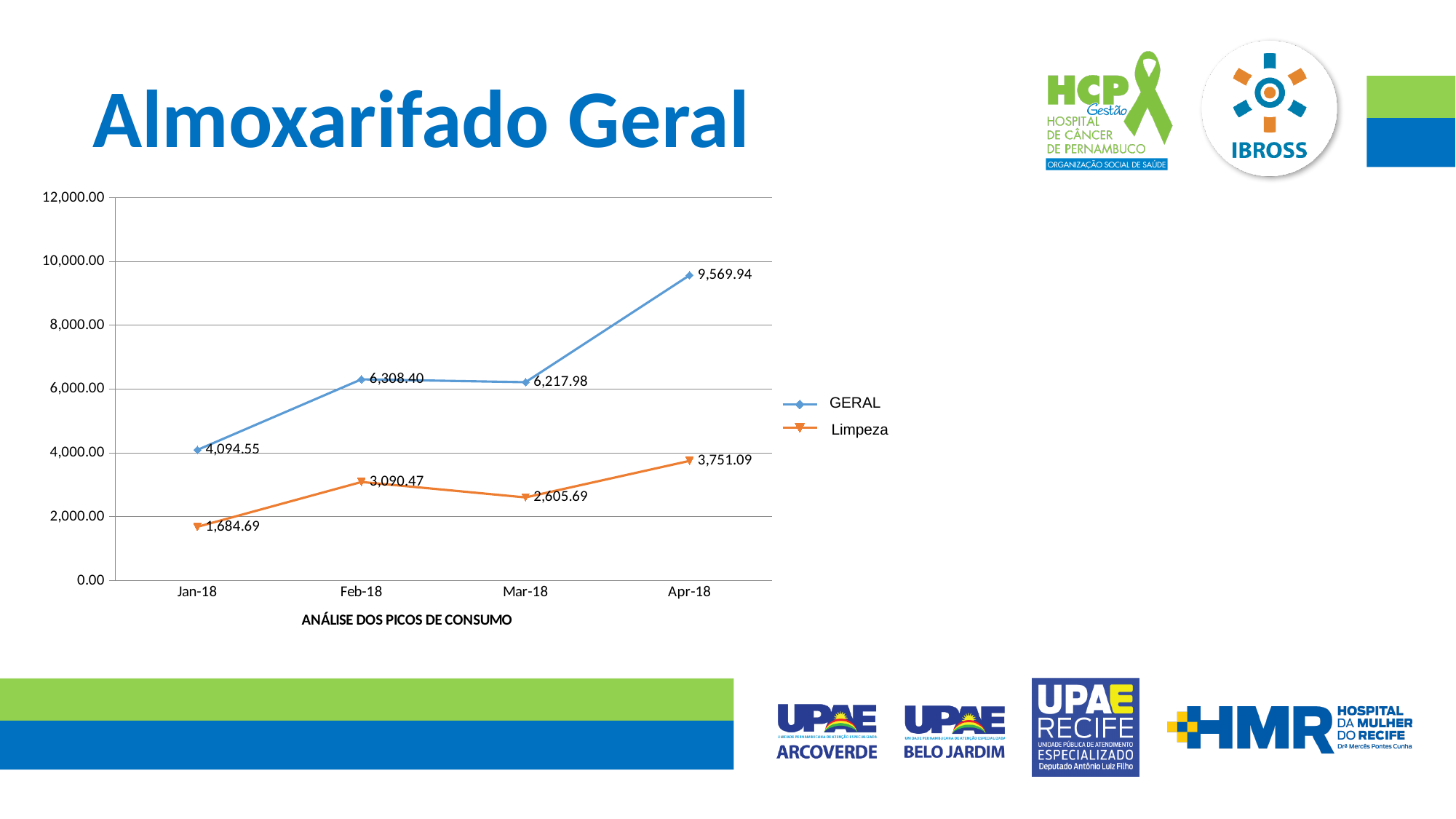
What is the Limpeza value for Mar-18? 2,605.69 What is the difference between the GERAL values for Apr-18 and Jan-18? 5,475.39 How many series does the legend list? 2 What is the GERAL value for Feb-18? 6,308.40 How many months are shown on the x axis? 4 What kind of chart is shown on the slide? Line chart In which month is the Limpeza series lowest? Jan-18 What is the GERAL value for Apr-18? 9,569.94 Which is larger, the GERAL value for Feb-18 or for Mar-18? Feb-18 In which month is the GERAL series highest? Apr-18 What is the difference between the GERAL and Limpeza values in Apr-18? 5,818.85 What is the Limpeza value for Jan-18? 1,684.69